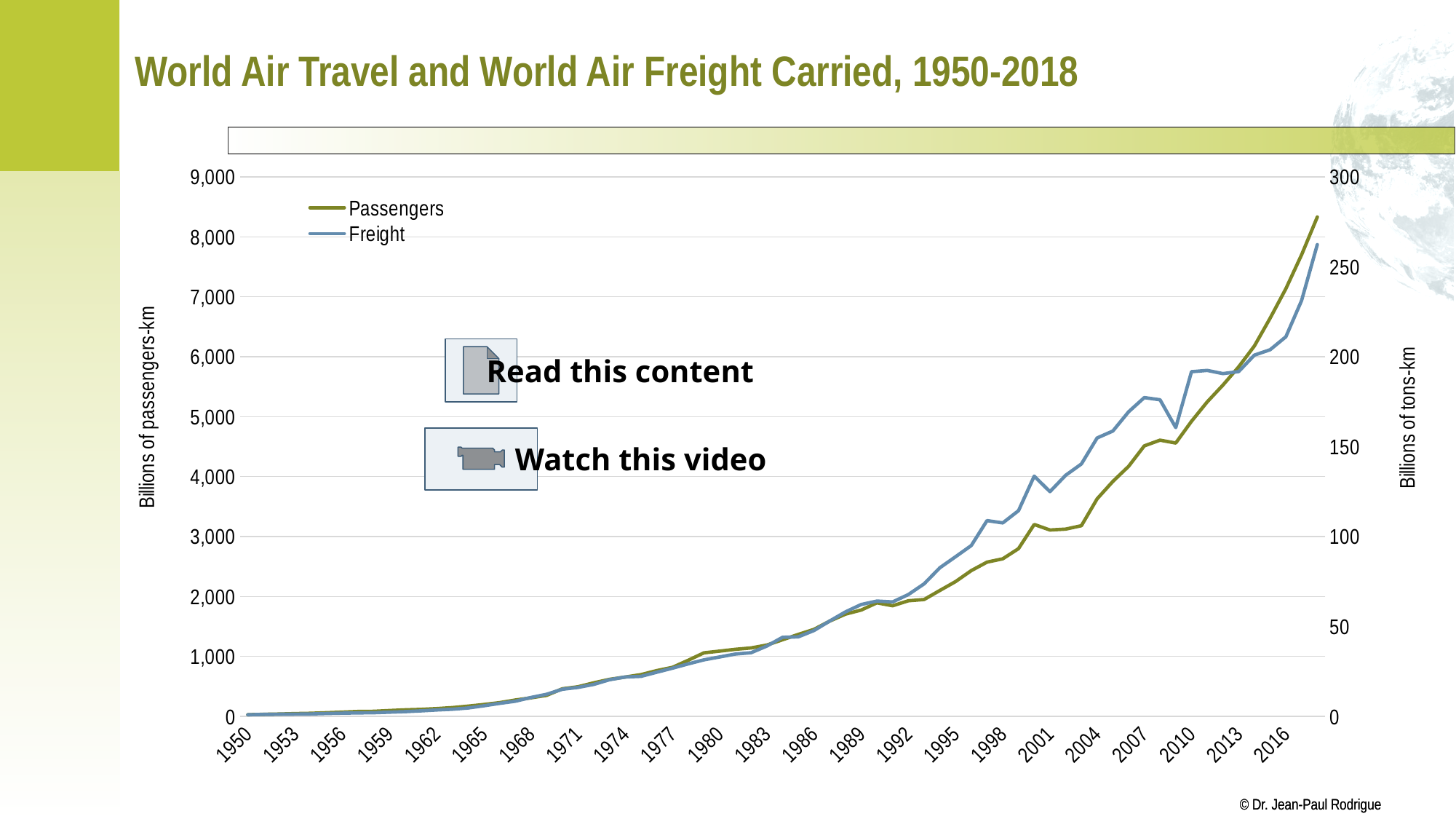
How many series does the legend list? 2 Is the Passengers value at the end of the series (2018) greater or less than 8,000 billion passengers-km? greater Is the Passengers value in 1980 greater or less than 2,000 billion passengers-km? less Is the Passengers value in 2007 greater or less than 4,000 billion passengers-km? greater What is the label of the left vertical axis? Billions of passengers-km What kind of chart is shown on the slide? line chart Do the Passengers values generally rise or fall from 1950 to 2018? rise What are the two series named in the legend? Passengers and Freight In which year does the Passengers series reach its highest value? 2018